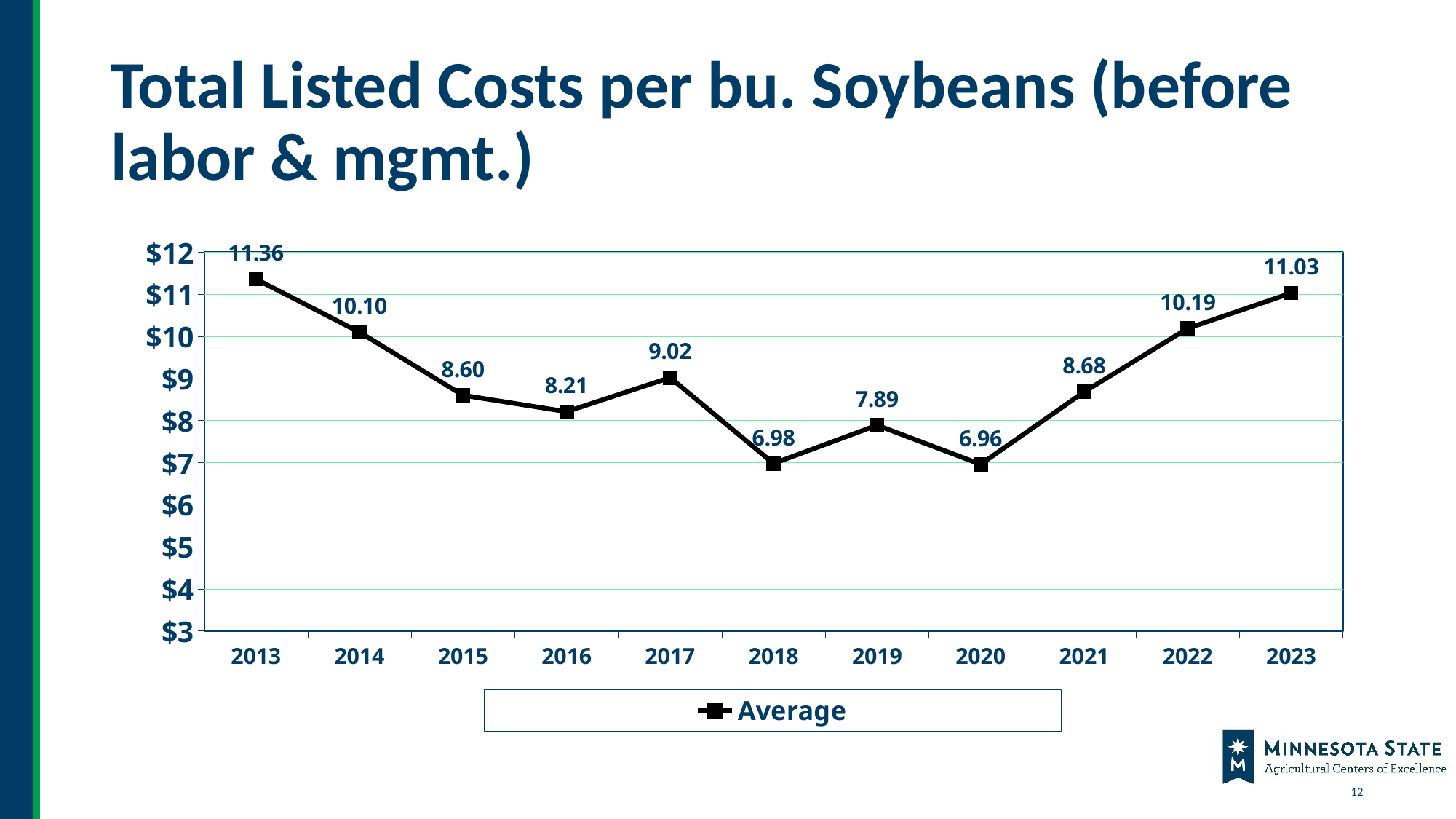
How many series does the legend list? 1 Which year has the highest value? 2013 What is the value for 2023? 11.03 What is the difference between the values for 2023 and 2022? 0.84 What kind of chart is shown? line chart How many years are plotted on the x axis? 11 Which year has the lowest value? 2020 Do the values rise or fall from 2020 to 2023? rise Is the value for 2019 greater or less than $8? less What is the value for 2020? 6.96 What is the value for 2013? 11.36 Which is larger, the value for 2017 or the value for 2021? 2017